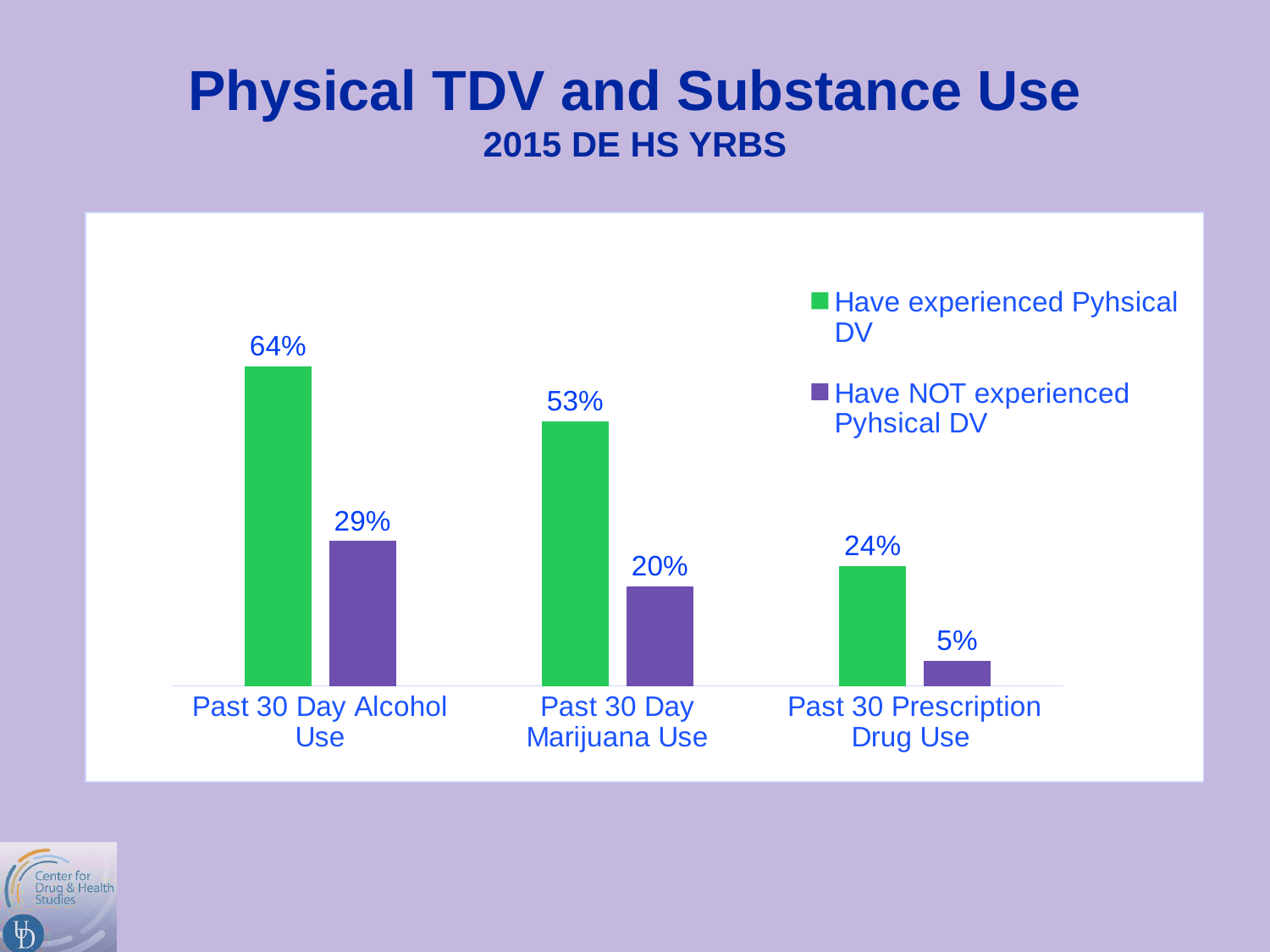
What is the value for Past 30 Day Marijuana Use among those who have NOT experienced Physical DV? 20% What is the value for Past 30 Prescription Drug Use among those who have experienced Physical DV? 24% What is the difference between the two series for Past 30 Day Alcohol Use? 35% What kind of chart is shown on the slide? Bar chart How many categories are shown on the x axis? 3 What is the value for Past 30 Day Alcohol Use among those who have experienced Physical DV? 64% Which category has the lowest value for the 'Have NOT experienced Physical DV' series? Past 30 Prescription Drug Use What is the difference between the two series for Past 30 Day Marijuana Use? 33% For Past 30 Prescription Drug Use, which series has the larger value? Have experienced Physical DV Which category has the highest value for the 'Have experienced Physical DV' series? Past 30 Day Alcohol Use How many series does the legend list? 2 Do the values for the 'Have experienced Physical DV' series rise or fall from left to right across the categories? Fall